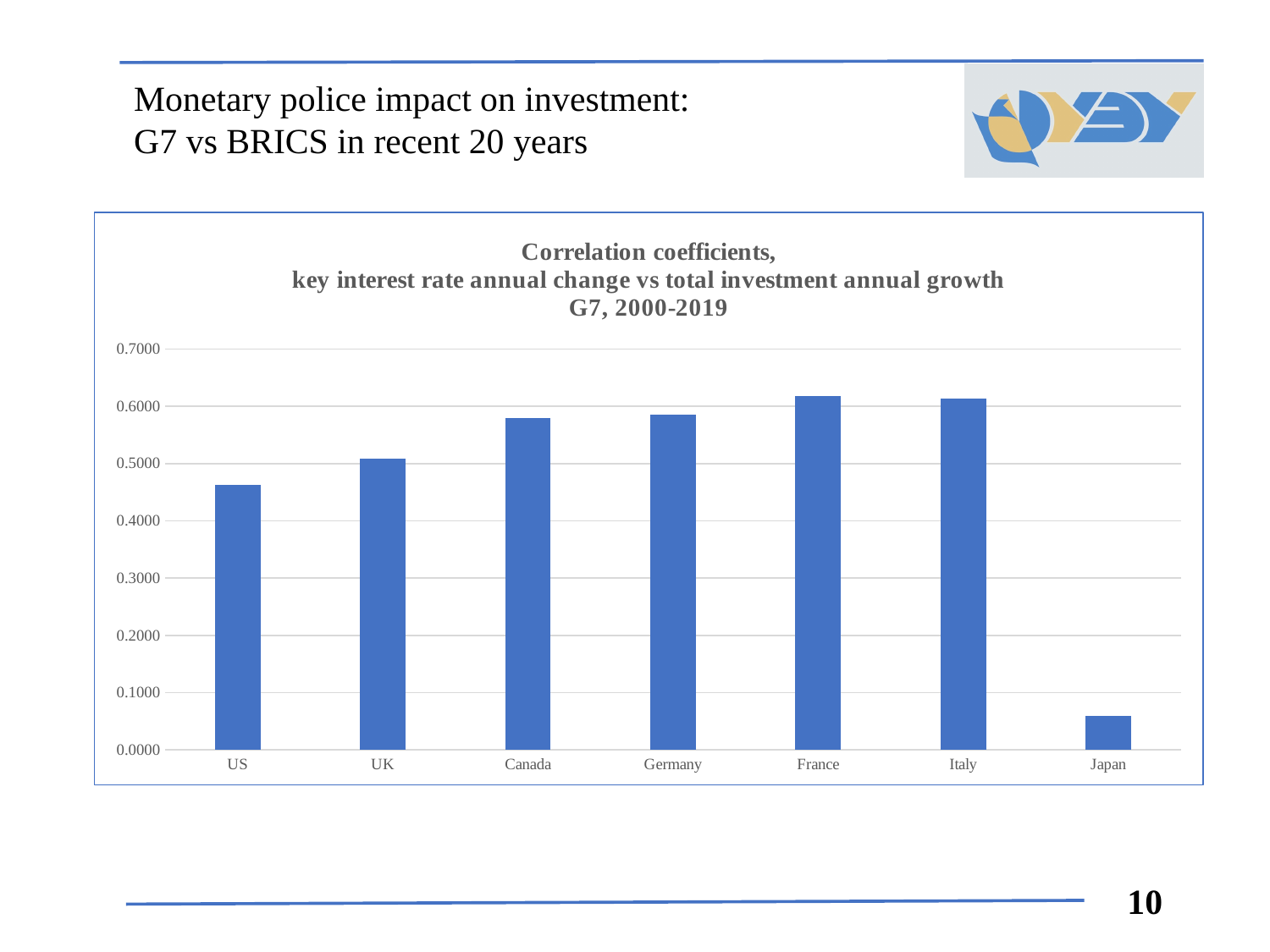
Which country has the lowest correlation coefficient in the chart? Japan Is the value for France greater or less than 0.6000? greater Which has the larger correlation coefficient, Japan or Germany? Germany Is the value for US greater or less than 0.5000? less Which group of countries and period does the chart title say the correlation coefficients cover? G7, 2000-2019 Is the value for Japan greater or less than 0.1000? less What kind of chart is shown on the slide? Bar chart Which has the larger correlation coefficient, US or UK? UK How many countries are shown on the x axis of the chart? 7